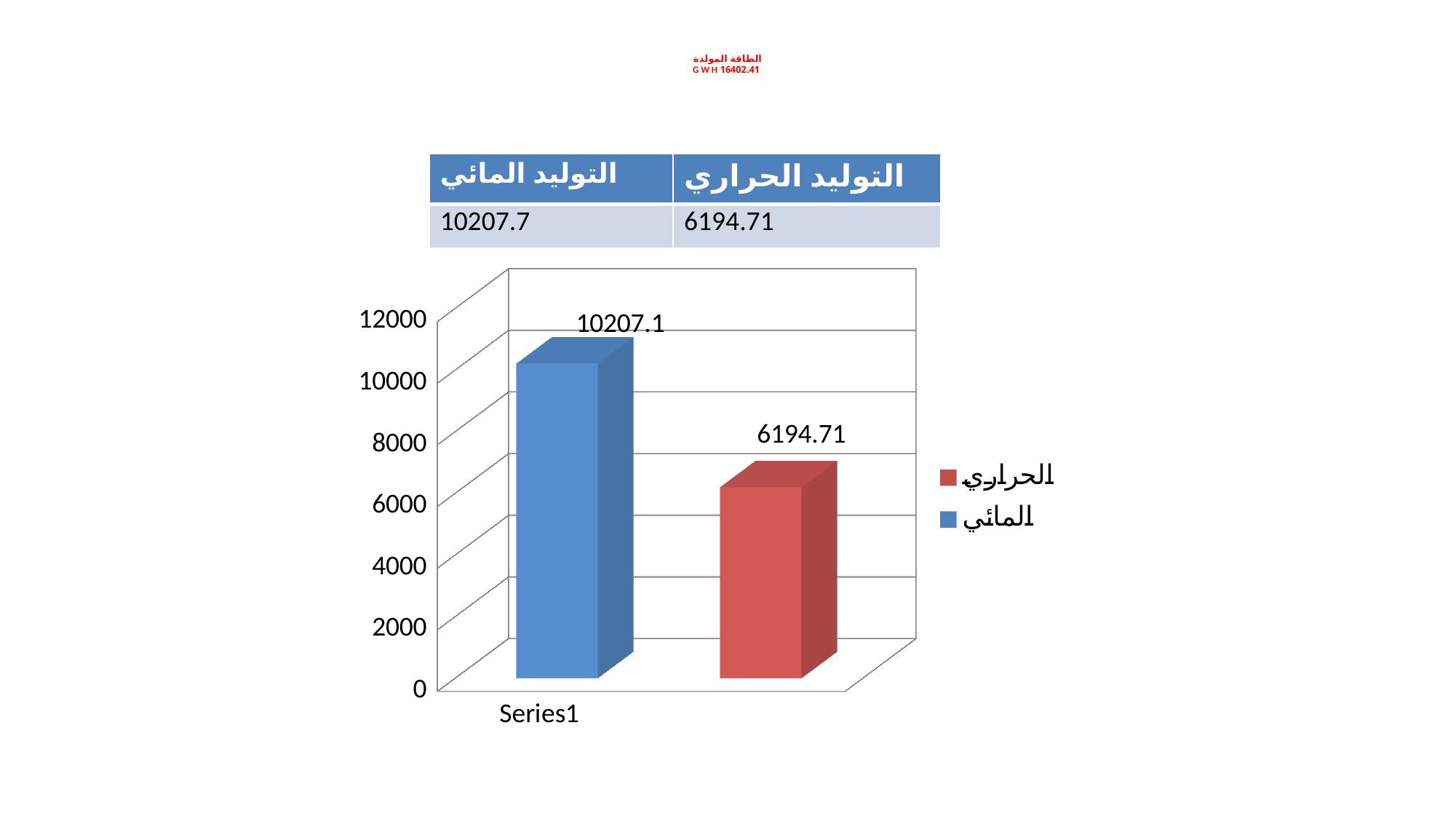
What is the value shown for the المائي series in the chart? 10207.1 What kind of chart is shown on the slide? bar chart What is the difference between the المائي value and the الحراري value in the chart? 4012.39 Which series has the lowest value in the chart? الحراري What colour is the bar for the الحراري series? red Is the value for المائي greater or less than 10000? greater How many series does the chart legend list? 2 Which series has the higher value in the chart, المائي or الحراري? المائي Is the value for الحراري greater or less than 8000? less What is the category label shown on the x axis of the chart? Series1 What is the value shown for the الحراري series in the chart? 6194.71 Which series has the highest value in the chart? المائي